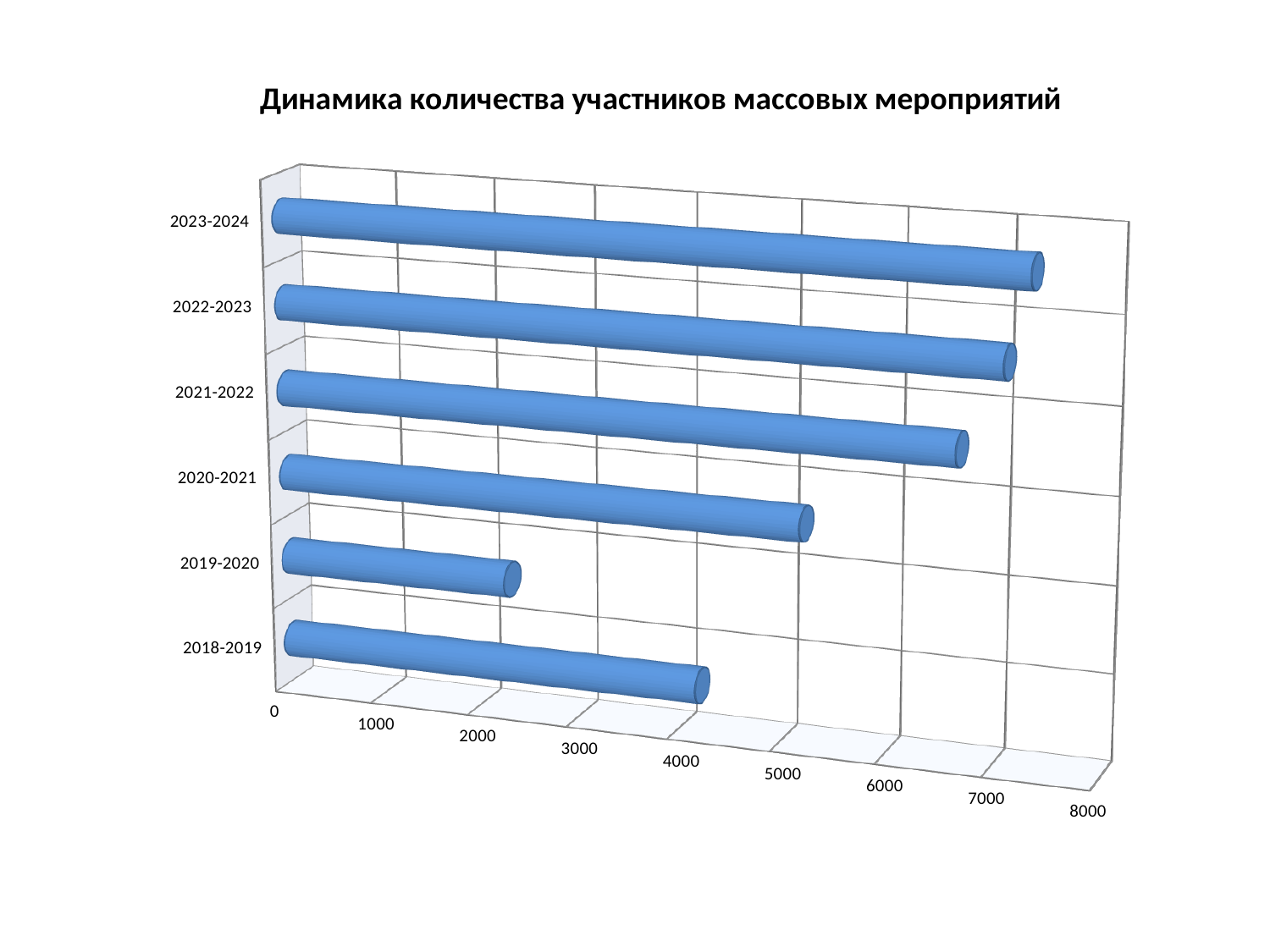
Is the value for 2018-2019 greater or less than 3000? greater Is the value for 2021-2022 greater or less than 6000? greater Which is larger, the value for 2019-2020 or the value for 2021-2022? 2021-2022 Which academic year has the lowest number of participants? 2019-2020 What is the title of the chart? Динамика количества участников массовых мероприятий Which is larger, the value for 2018-2019 or the value for 2020-2021? 2020-2021 Which academic year has the highest number of participants? 2023-2024 How many categories (academic years) are shown on the chart? 6 Is the value for 2019-2020 greater or less than 3000? less What kind of chart is shown on the slide? bar chart